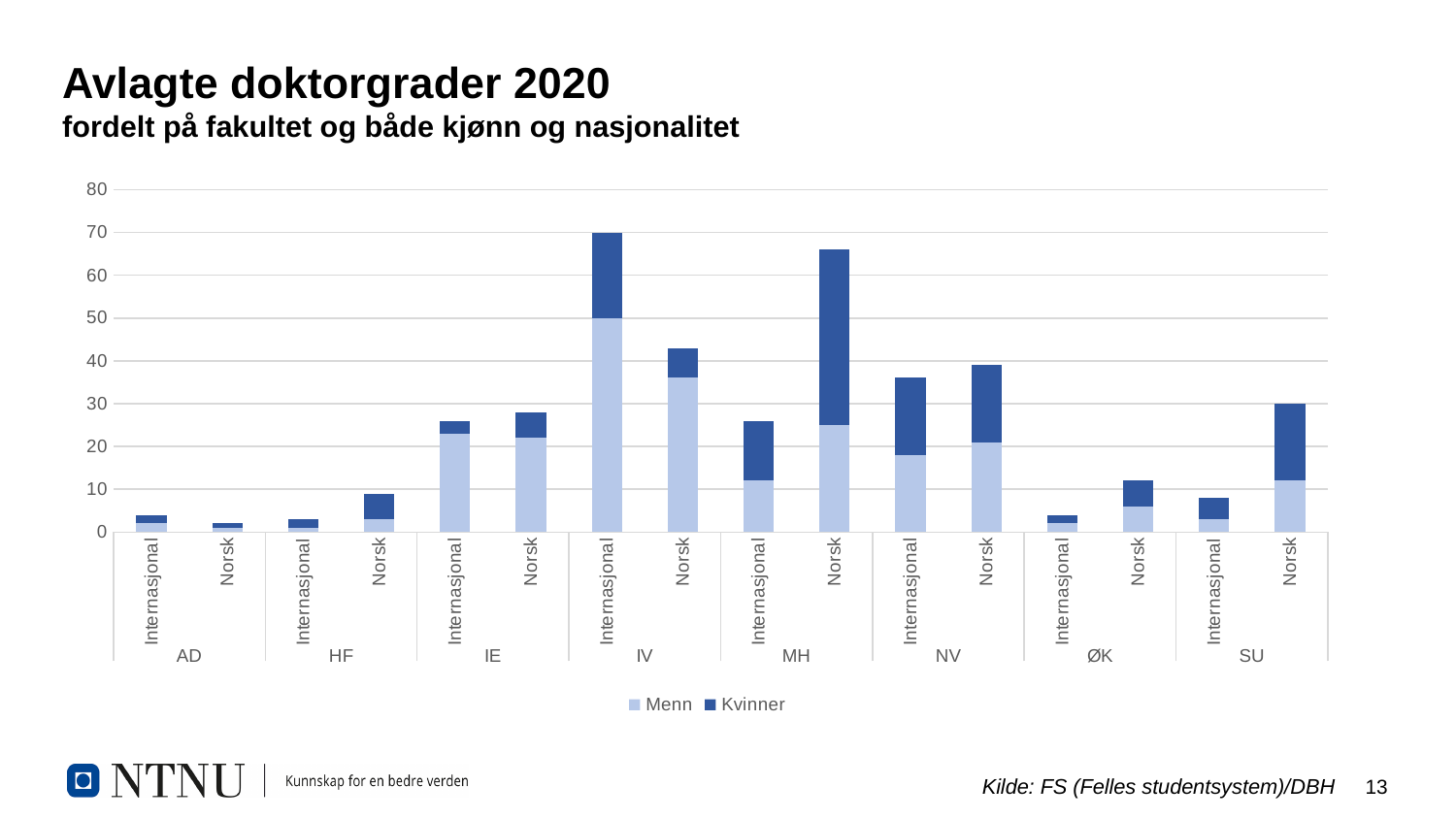
Is the total for IE Norsk greater or less than 20? greater Which bar is the tallest in the chart? IV Internasjonal What is the total height of the IV Internasjonal bar? 70 How many faculties are shown along the x axis? 8 What kind of chart is shown on the slide? bar chart How many series does the legend list? 2 What are the two series named in the legend? Menn and Kvinner Is the total for NV Internasjonal greater or less than 40? less Which is larger, the MH Norsk bar or the NV Norsk bar? MH Norsk Is the total for SU Internasjonal greater or less than 10? less Within the IV faculty, which bar is taller, Internasjonal or Norsk? Internasjonal